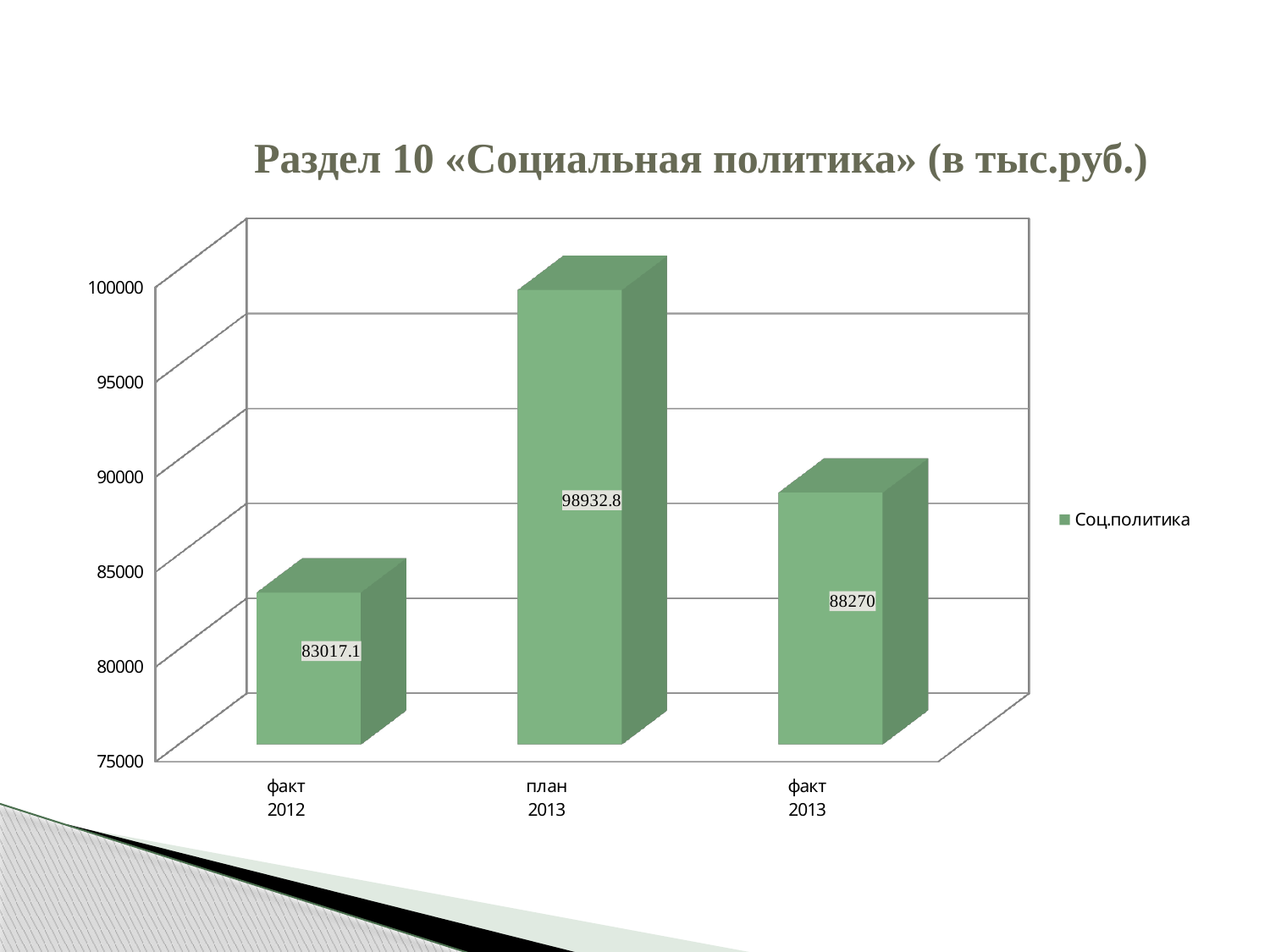
Which category has the lowest value? факт 2012 Which is larger, факт 2012 or факт 2013? факт 2013 What is the value for факт 2012? 83017.1 Which category has the highest value? план 2013 How many series does the legend list? 1 What is the value for факт 2013? 88270 What kind of chart is shown on the slide? bar chart What is the name of the series in the legend? Соц.политика How many categories are shown on the x axis? 3 What is the difference between факт 2013 and факт 2012? 5252.9 What is the value for план 2013? 98932.8 What is the difference between план 2013 and факт 2013? 10662.8